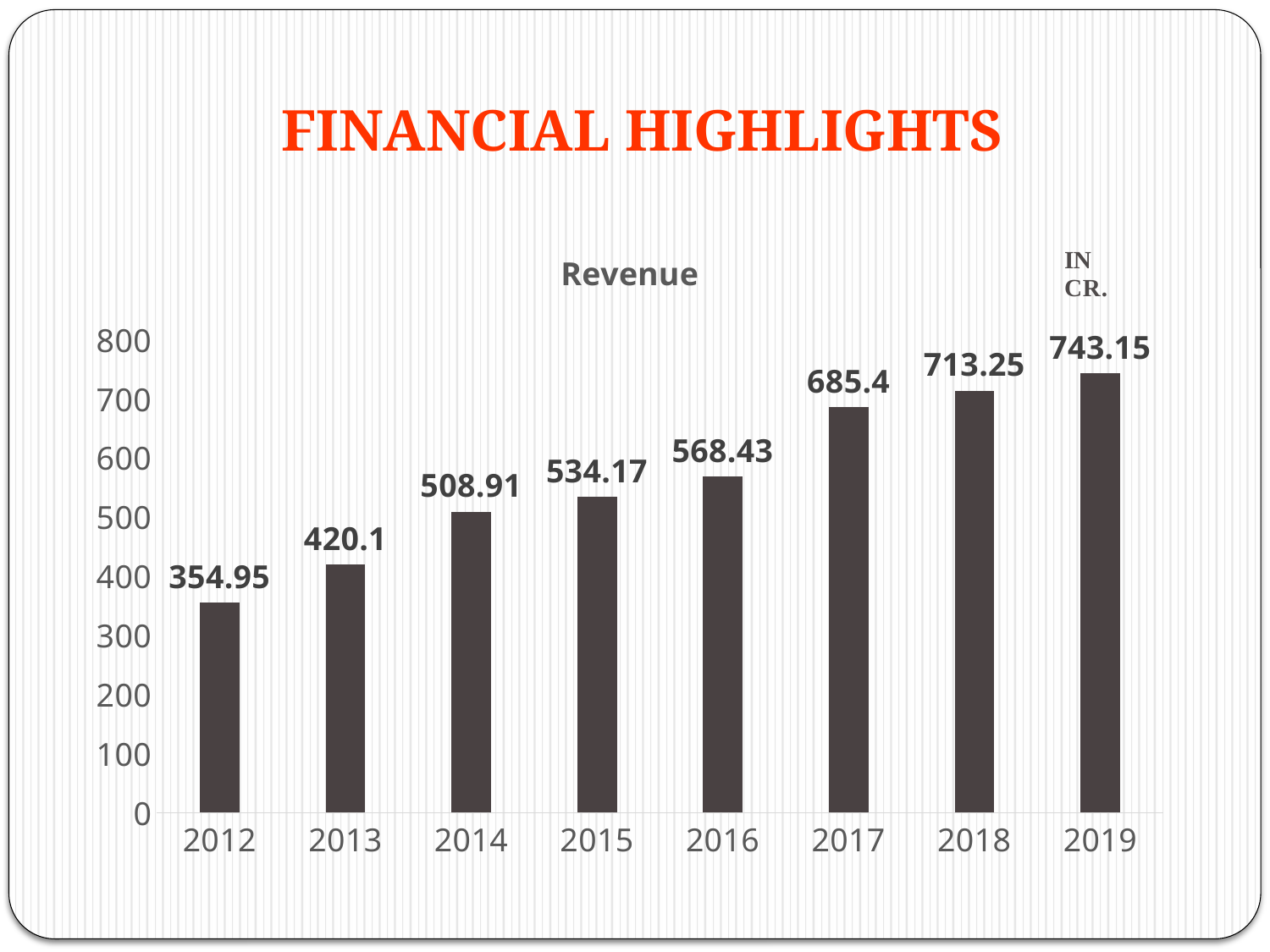
Which year has the lowest revenue? 2012 How many years are shown on the chart? 8 What is the revenue value for 2019? 743.15 What is the difference between the revenue in 2013 and the revenue in 2012? 65.15 Which year has the highest revenue? 2019 Is the revenue for 2015 greater or less than 500? greater What kind of chart is shown on the slide? bar chart What is the revenue value for 2016? 568.43 Which is larger, the revenue in 2014 or the revenue in 2017? 2017 What is the difference between the revenue in 2019 and the revenue in 2018? 29.9 What is the revenue value for 2012? 354.95 Do the revenue values rise or fall from 2012 to 2019? rise